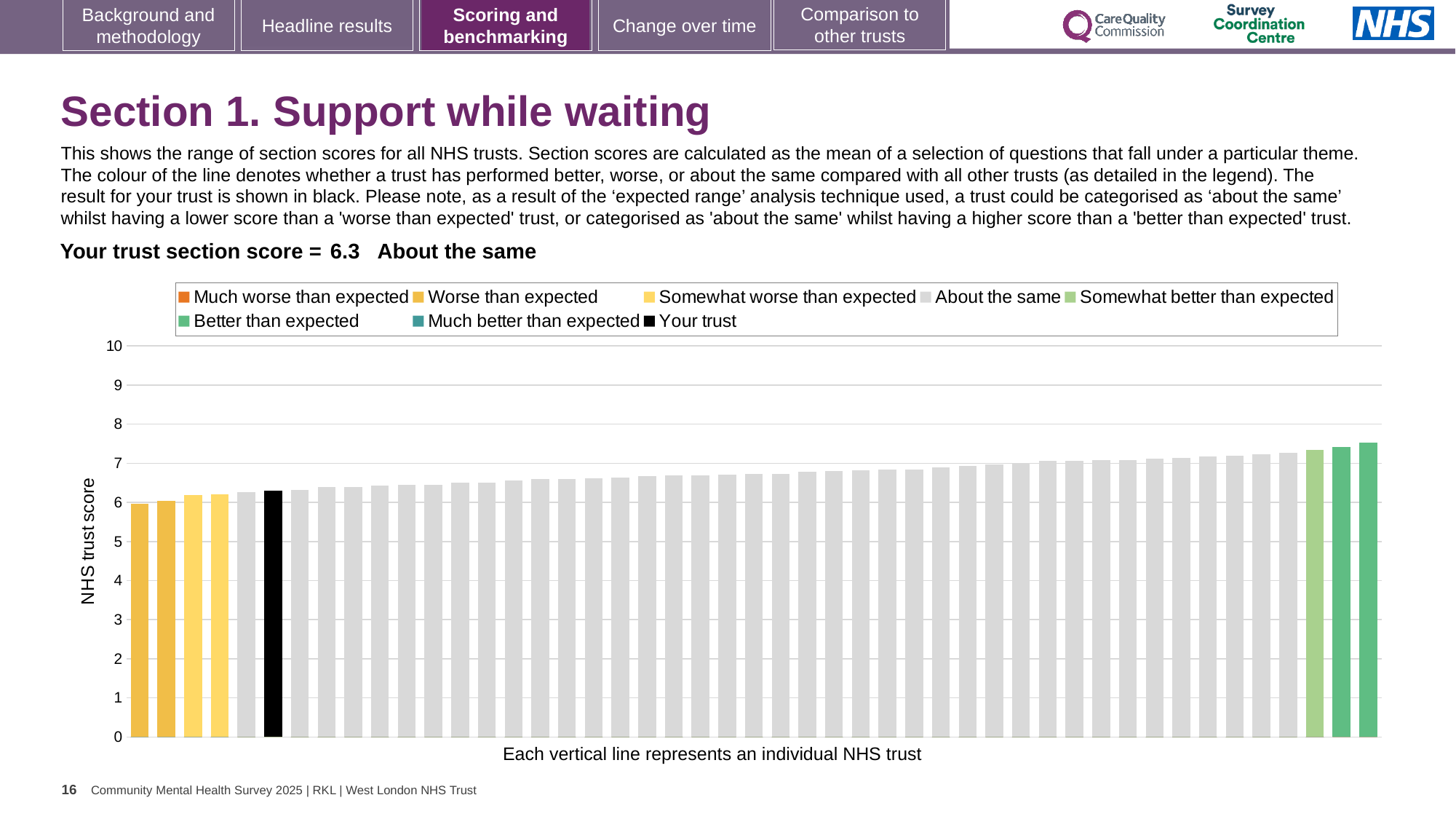
What is the section score for your trust shown on the slide? 6.3 Is the value for your trust (the black bar) greater or less than 5? greater What is the label on the vertical axis of the chart? NHS trust score Is the value of the shortest bar on the chart greater or less than 7? less What kind of chart is shown on the slide? bar chart How many bars are coloured as 'Better than expected' (green) on the chart? 2 How many bars are coloured as 'Worse than expected' (dark yellow) on the chart? 2 Is the value of the shortest bar on the chart greater or less than 5? greater Which category is your trust placed in for this section? About the same Do the bar values rise or fall from left to right along the x axis? rise How many entries does the chart legend list? 8